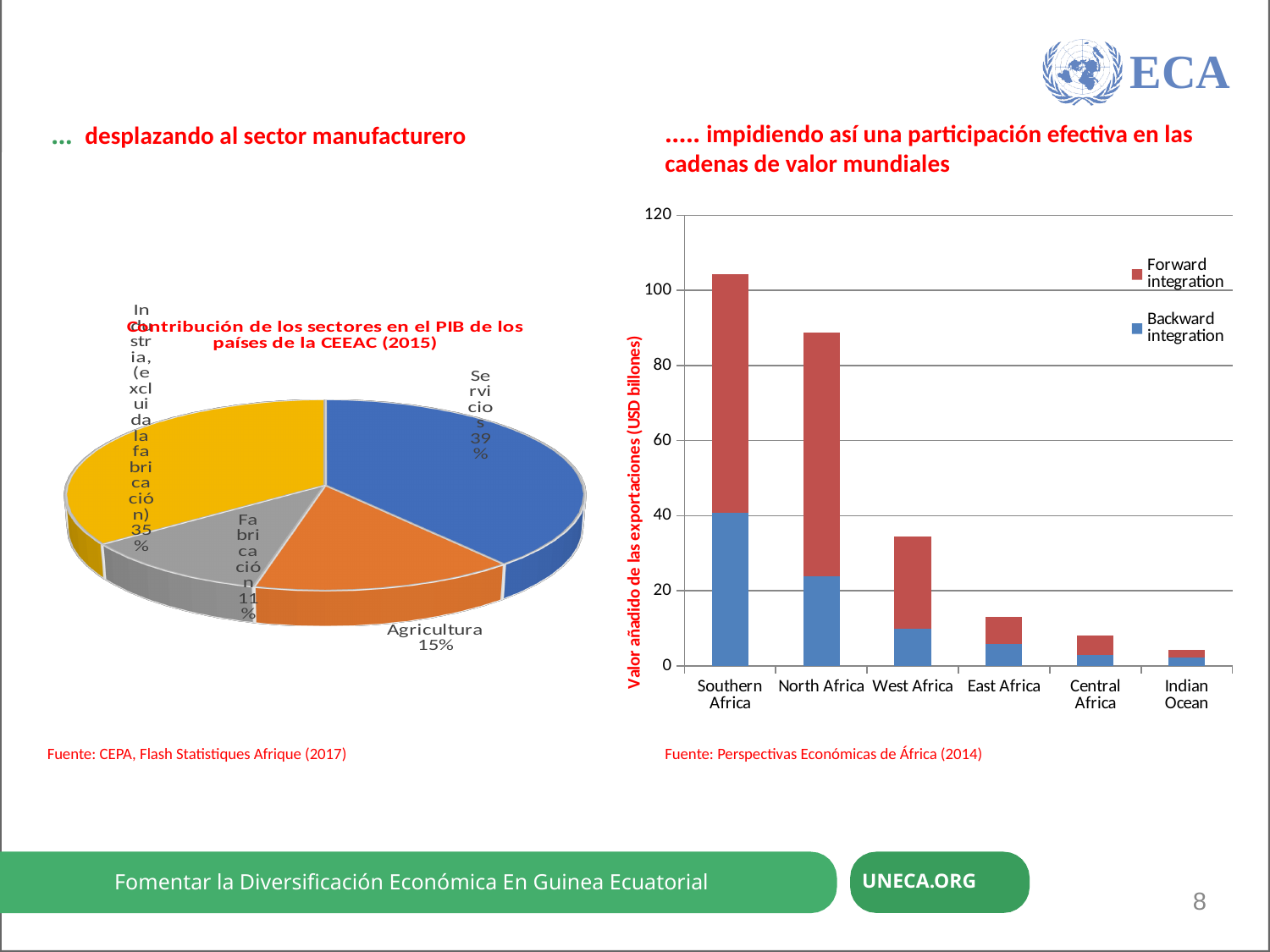
In the bar chart on the right, how many series does the legend list? 2 What kind of chart is the chart on the left of the slide? Pie chart In the bar chart on the right, which region has the lowest total bar? Indian Ocean In the pie chart 'Contribución de los sectores en el PIB de los países de la CEEAC (2015)', what share does Agricultura have? 15% In the bar chart on the right, is the total value for Southern Africa greater or less than 100? greater In the bar chart on the right, how many regions are shown on the x axis? 6 In the pie chart 'Contribución de los sectores en el PIB de los países de la CEEAC (2015)', how many slices are there? 4 In the pie chart 'Contribución de los sectores en el PIB de los países de la CEEAC (2015)', what share does Servicios have? 39% In the pie chart 'Contribución de los sectores en el PIB de los países de la CEEAC (2015)', what share does Fabricación have? 11% In the pie chart 'Contribución de los sectores en el PIB de los países de la CEEAC (2015)', which sector has the smallest share? Fabricación In the pie chart 'Contribución de los sectores en el PIB de los países de la CEEAC (2015)', how many percentage points larger is Servicios than Agricultura? 24 In the pie chart 'Contribución de los sectores en el PIB de los países de la CEEAC (2015)', which sector has the largest share? Servicios